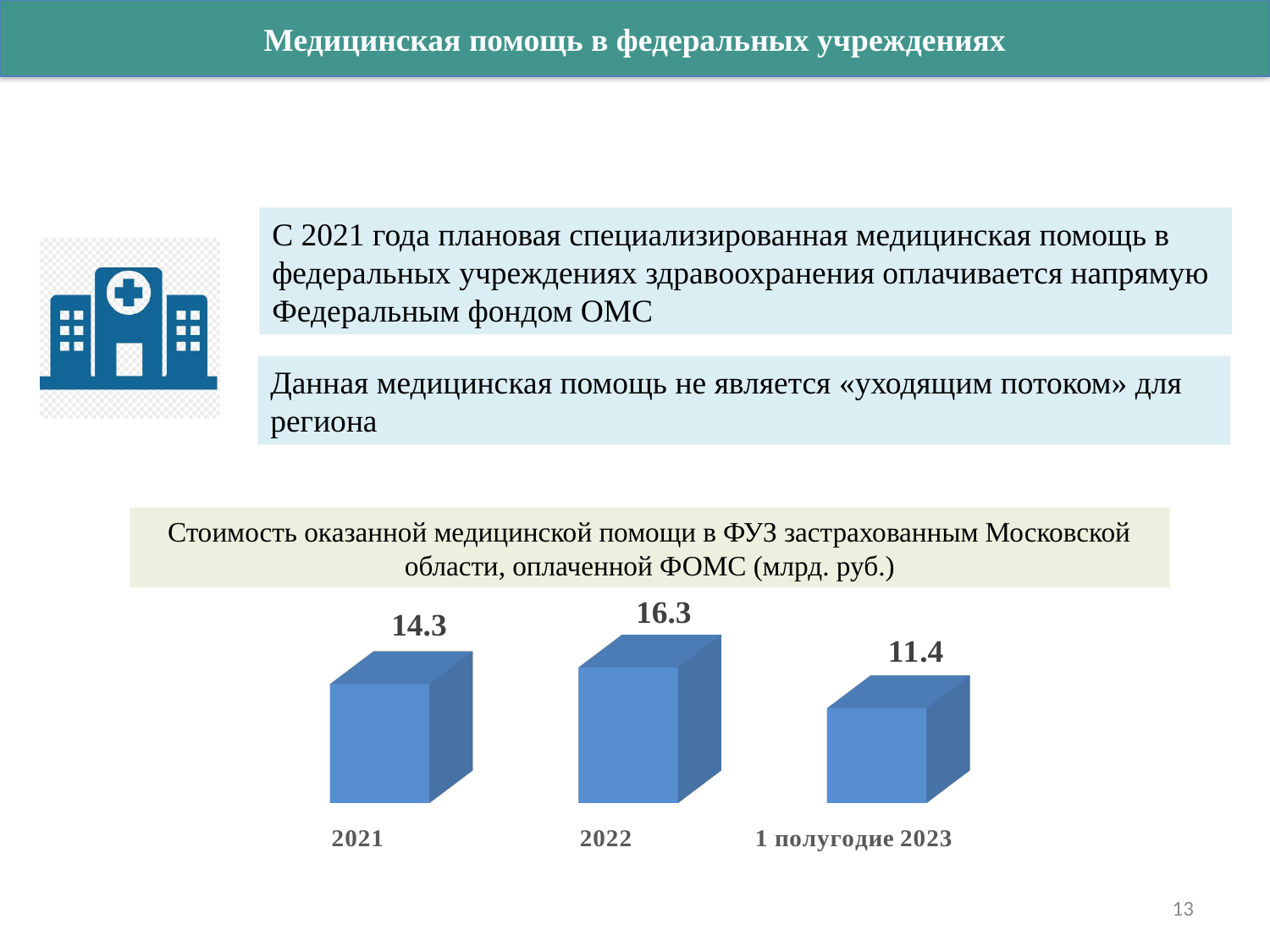
What is the value for 2022? 16.3 What is the value for 2021? 14.3 What unit is stated in the chart title? млрд. руб. What is the difference between the values for 2021 and 1 полугодие 2023? 2.9 What is the total of the values for 2021 and 2022? 30.6 What kind of chart is shown on the slide? bar chart Which is larger, the value for 2021 or the value for 2022? 2022 How many categories are shown in the chart? 3 Which category has the highest value? 2022 What is the value for 1 полугодие 2023? 11.4 Which category has the lowest value? 1 полугодие 2023 What is the difference between the values for 2022 and 2021? 2.0